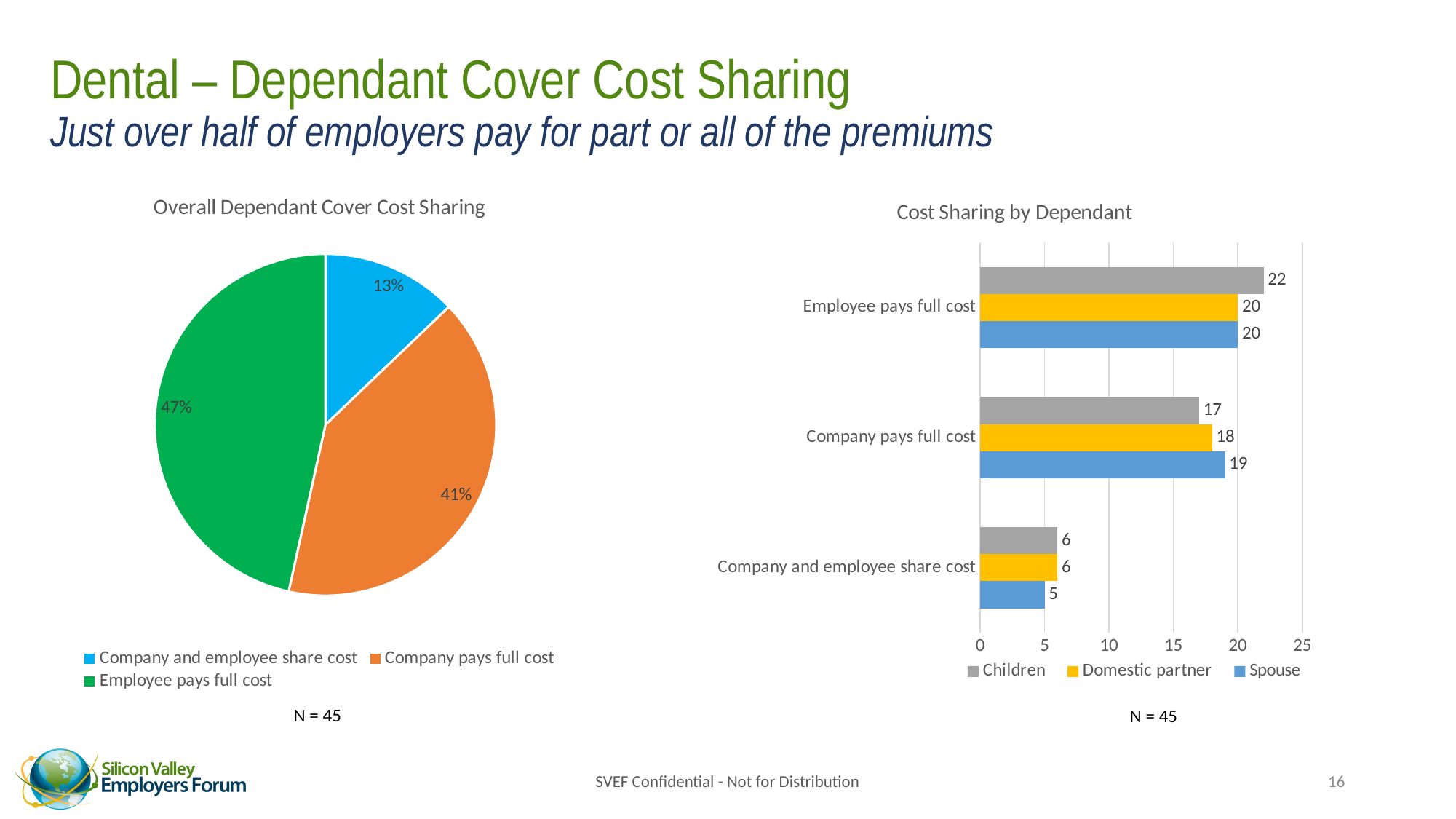
In the 'Cost Sharing by Dependant' chart, what is the difference between the Children value and the Spouse value for 'Employee pays full cost'? 2 What kind of chart is 'Overall Dependant Cover Cost Sharing'? Pie chart In the 'Overall Dependant Cover Cost Sharing' chart, which category has the smallest slice? Company and employee share cost In the 'Cost Sharing by Dependant' chart, what is the value for Spouse under 'Company and employee share cost'? 5 What kind of chart is 'Cost Sharing by Dependant'? Bar chart In the 'Cost Sharing by Dependant' chart, what is the value for Children under 'Employee pays full cost'? 22 In the 'Overall Dependant Cover Cost Sharing' chart, which category has the largest slice? Employee pays full cost In the 'Overall Dependant Cover Cost Sharing' chart, what percentage is shown for 'Employee pays full cost'? 47% How many series does the legend of the 'Cost Sharing by Dependant' chart list? 3 In the 'Cost Sharing by Dependant' chart, what is the value for Spouse under 'Company pays full cost'? 19 In the 'Cost Sharing by Dependant' chart, which is larger for 'Company pays full cost': Domestic partner or Children? Domestic partner In the 'Overall Dependant Cover Cost Sharing' chart, what percentage is shown for 'Company and employee share cost'? 13%